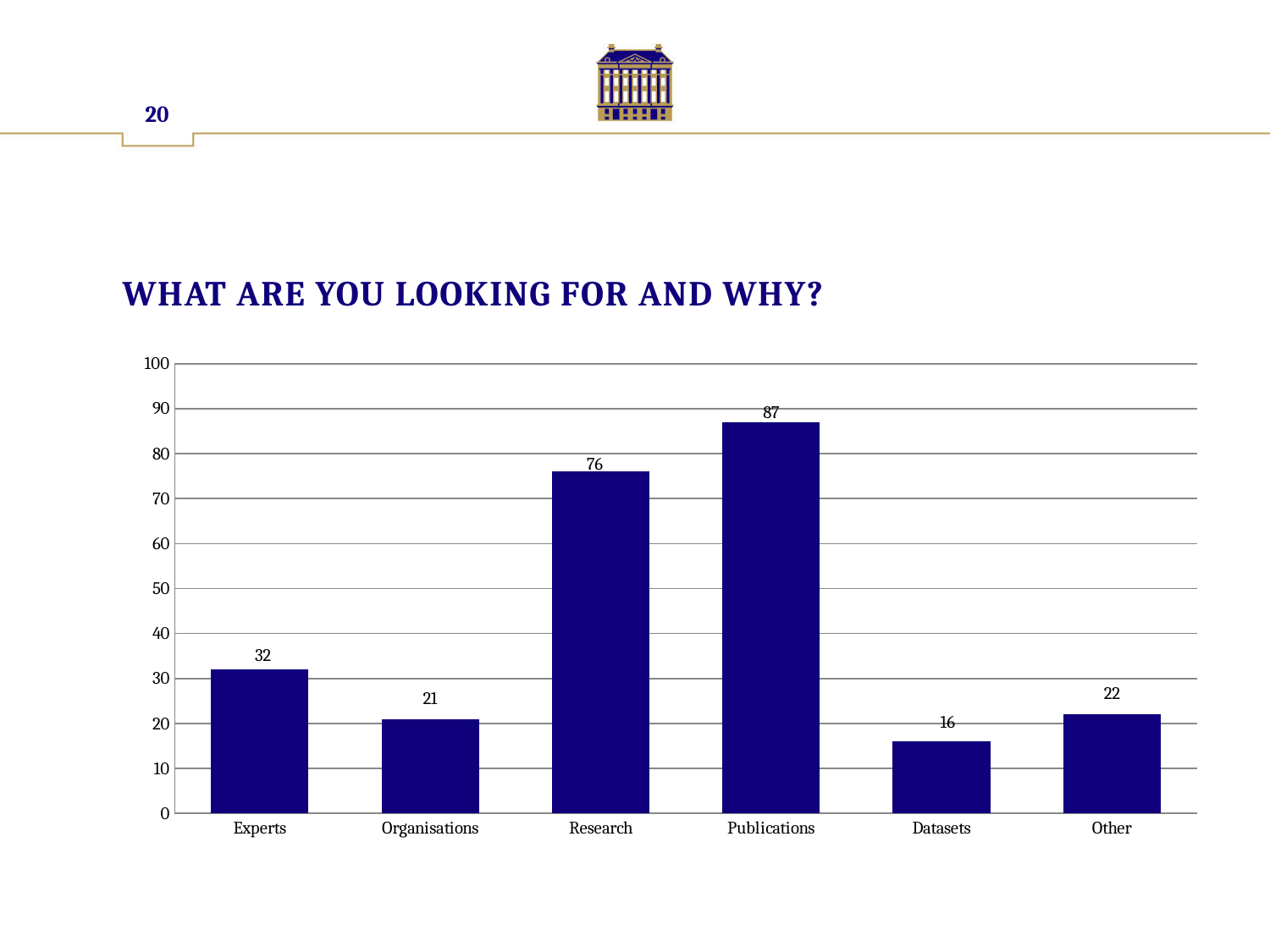
Is the value for Research greater or less than 70? greater What is the value for Publications? 87 How many categories are shown on the x axis? 6 Which category has the highest value? Publications What kind of chart is shown on the slide? Bar chart What is the value for Experts? 32 What is the value for Datasets? 16 Which is larger, the value for Other or the value for Organisations? Other What is the title of the slide above the chart? WHAT ARE YOU LOOKING FOR AND WHY? What is the difference between the values for Publications and Research? 11 Which category has the lowest value? Datasets What is the difference between the values for Experts and Organisations? 11